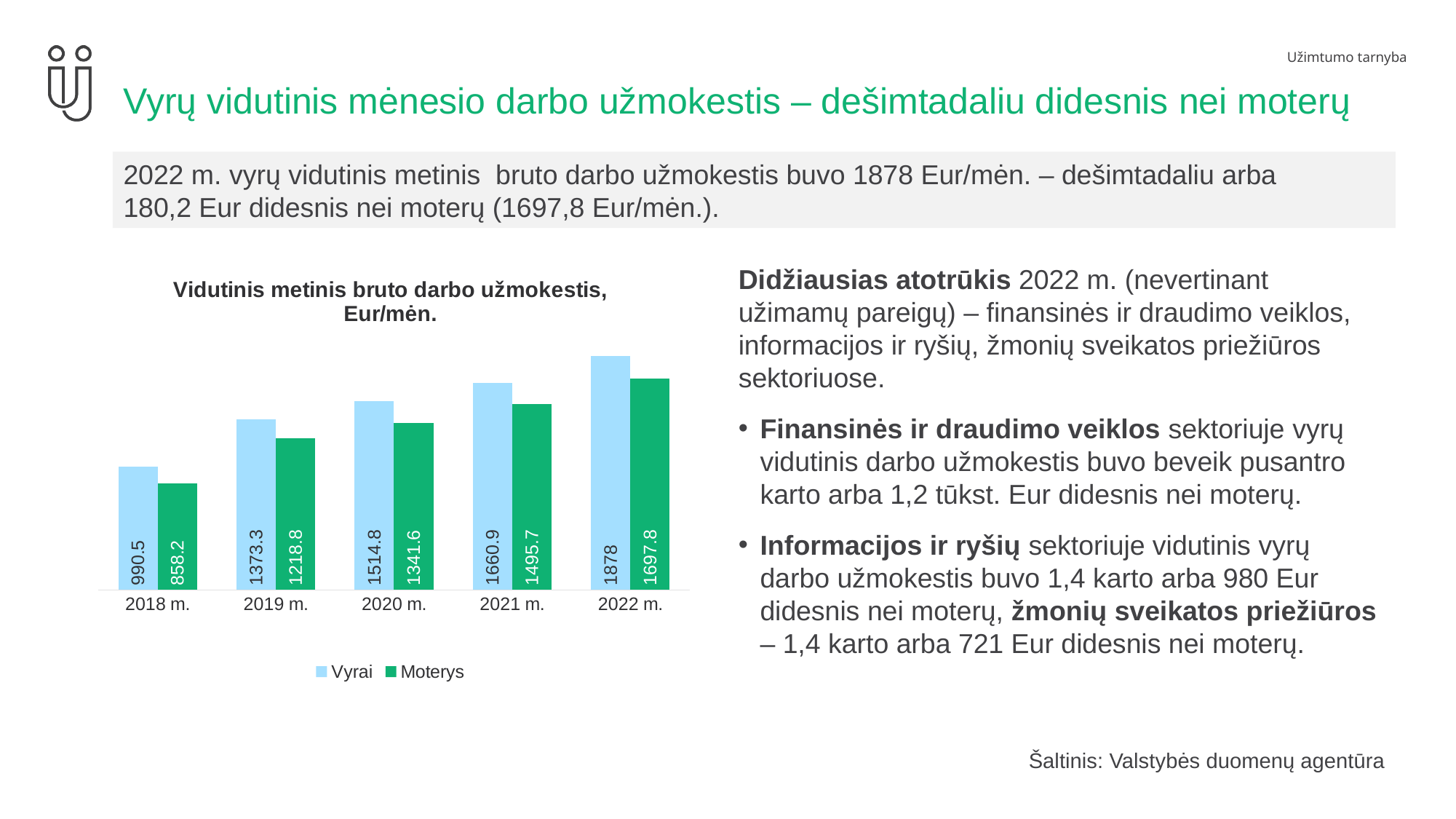
What is the value for Vyrai in 2018 m.? 990.5 Which is larger in 2021 m., the Vyrai value or the Moterys value? Vyrai What is the value for Moterys in 2021 m.? 1495.7 In which year is the Moterys value highest? 2022 m. In which year is the Vyrai value lowest? 2018 m. What is the difference between the Vyrai and Moterys values in 2020 m.? 173.2 How many years are shown on the x axis? 5 How many series does the legend list? 2 What kind of chart is shown? Bar chart Do the Vyrai values rise or fall from 2018 m. to 2022 m.? Rise What is the value for Moterys in 2019 m.? 1218.8 What is the value for Vyrai in 2022 m.? 1878